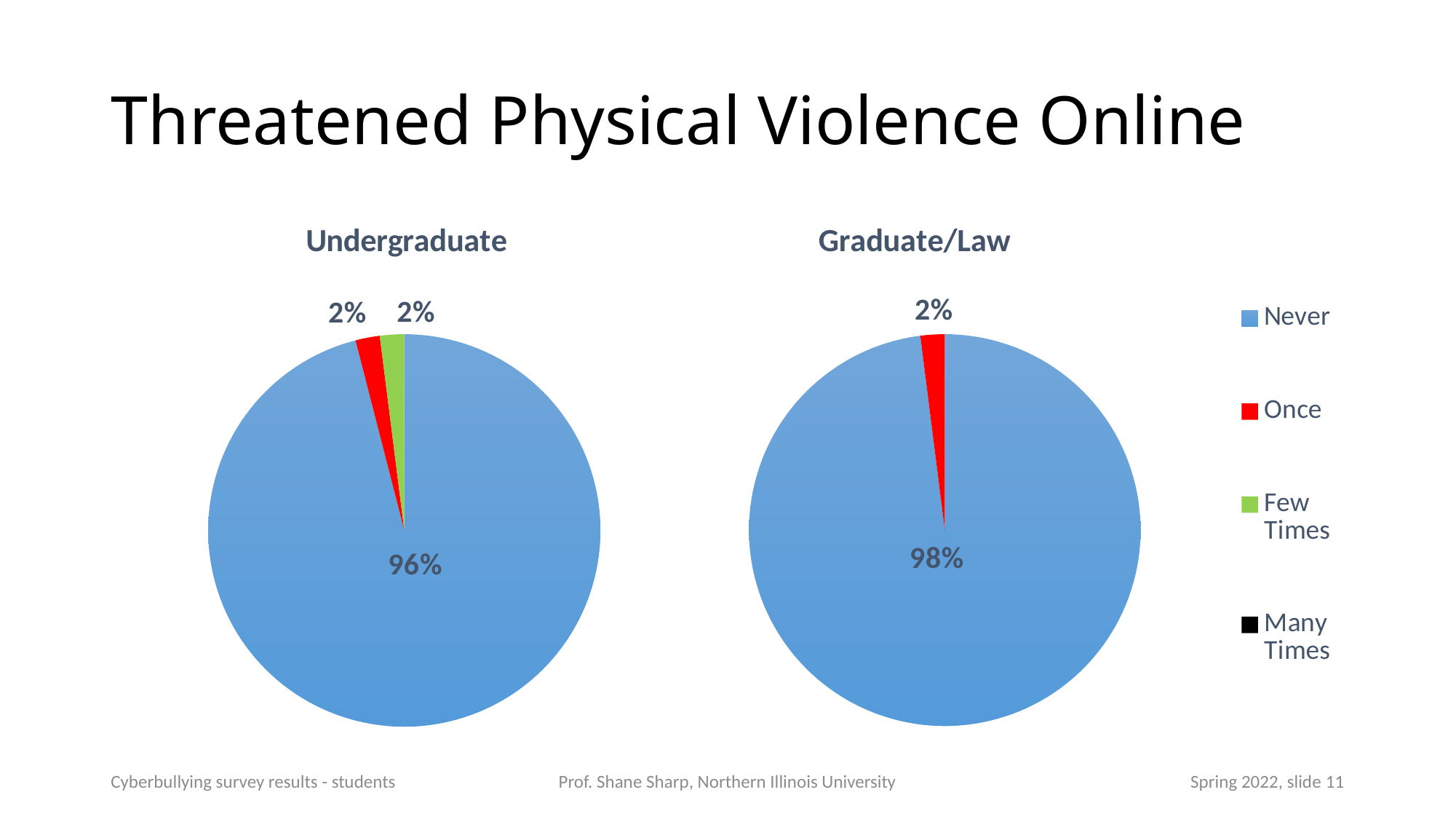
What is the difference between the Never share in the Graduate/Law chart and the Never share in the Undergraduate chart? 2% In the Graduate/Law chart, which category has the largest share? Never What colour represents the Once category in the charts? Red In the Graduate/Law chart, what percentage of respondents answered Never? 98% How many entries does the legend list? 4 What type of chart is used on this slide? Pie chart Which chart has the larger Never share, Undergraduate or Graduate/Law? Graduate/Law In the Undergraduate chart, which category has the largest share? Never In the Undergraduate chart, what percentage of respondents answered Never? 96% In the Graduate/Law chart, what percentage of respondents answered Once? 2% In the Undergraduate chart, what percentage of respondents answered Few Times? 2% In the Undergraduate chart, what percentage of respondents answered Once? 2%